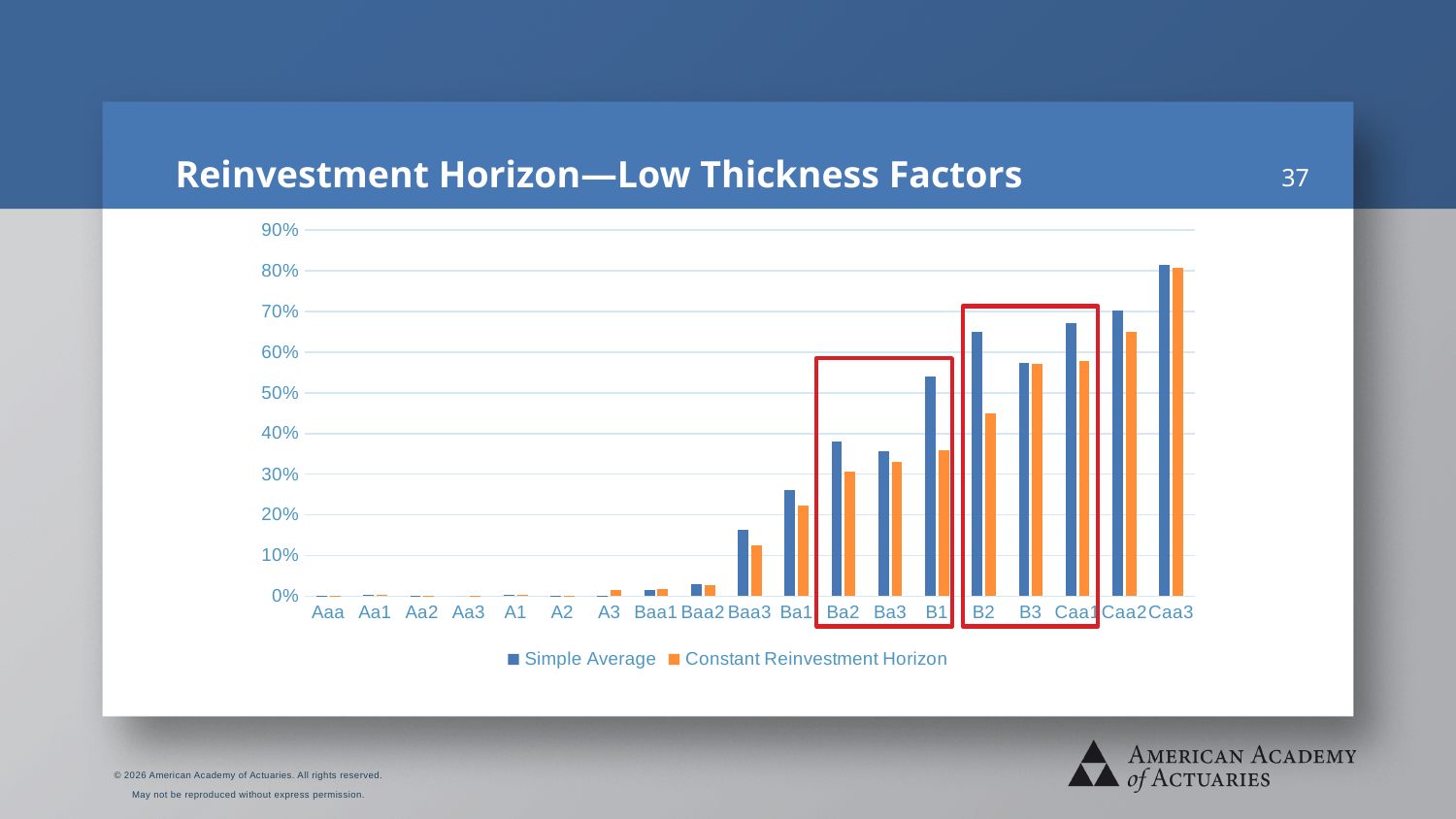
How many series does the legend list? 2 Is the Constant Reinvestment Horizon value for B2 greater or less than 50%? less What kind of chart is shown on the slide? Bar chart Is the Simple Average value for B2 greater or less than 60%? greater What colour represents the Constant Reinvestment Horizon series? Orange Which rating category has the highest Simple Average value? Caa3 Do the values generally rise or fall moving from Aaa to Caa3 along the x axis? Rise How many rating categories are shown on the x axis? 19 Is the Constant Reinvestment Horizon value for Ba2 greater or less than 40%? less For B2, which series has the larger value, Simple Average or Constant Reinvestment Horizon? Simple Average Which is larger, the Simple Average value for Caa2 or the Simple Average value for B2? Caa2